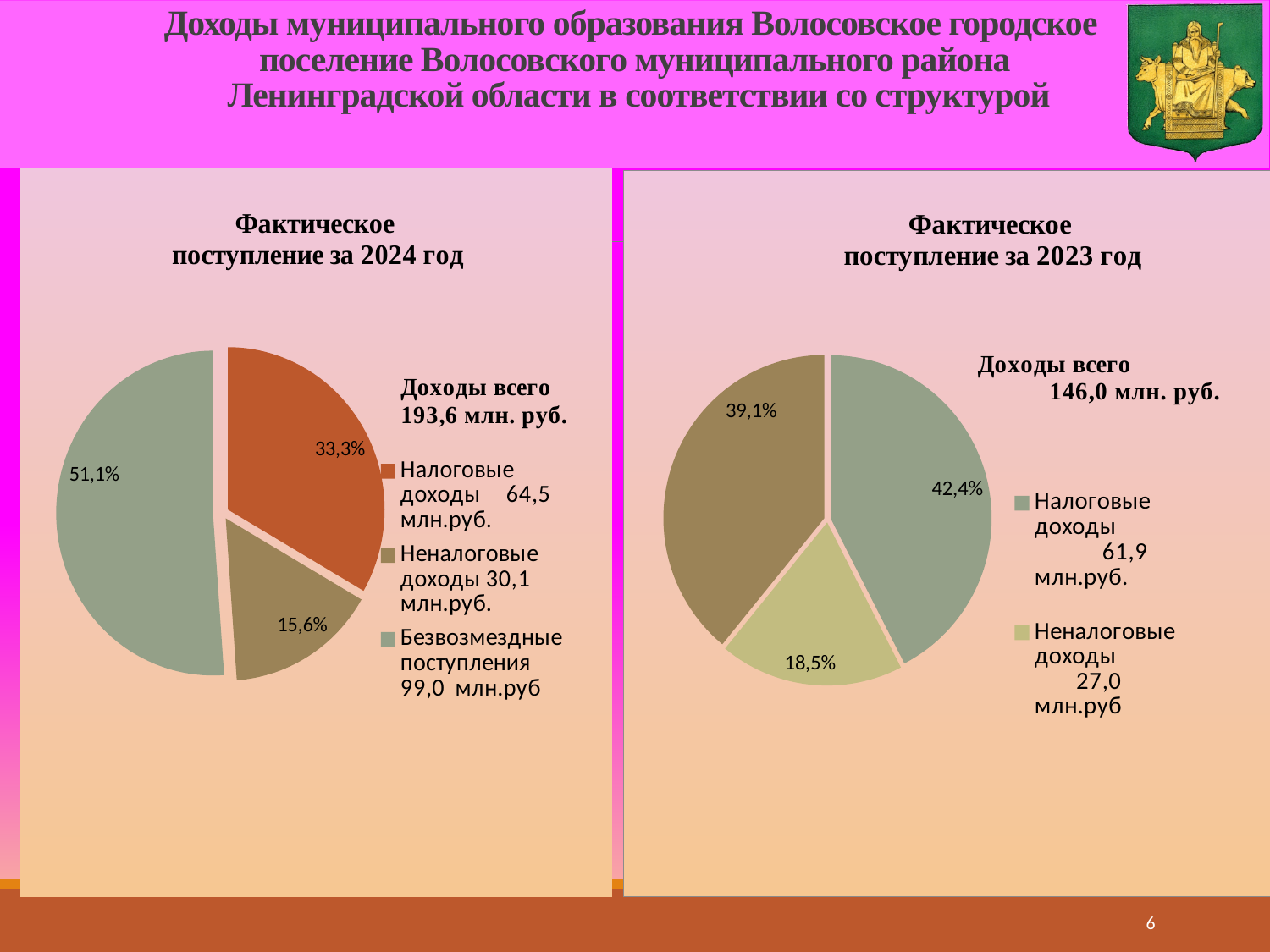
In the 2023 chart (right), how many slices does the pie have? 3 In the 2024 chart (left), which category has the largest slice? Безвозмездные поступления What is the difference between the Неналоговые доходы share in the 2023 chart (18,5%) and in the 2024 chart (15,6%)? 2,9% What kind of chart is shown under the title "Фактическое поступление за 2024 год"? Pie chart In the 2024 chart (left), how many entries does the legend list? 3 In the 2023 chart (right), what share of the pie is labelled for Налоговые доходы? 42,4% In the 2024 chart (left), what share of the pie is labelled for Налоговые доходы? 33,3% In the 2024 chart (left), what share of the pie is labelled for Безвозмездные поступления? 51,1% In the 2023 chart (right), what value in млн.руб. does the legend give for Неналоговые доходы? 27,0 млн.руб Which is larger: the Налоговые доходы share in the 2024 chart (33,3%) or in the 2023 chart (42,4%)? 2023 chart (42,4%) In the 2024 chart (left), what value in млн.руб. does the legend give for Неналоговые доходы? 30,1 млн.руб. In the 2024 chart (left), which category has the smallest slice? Неналоговые доходы